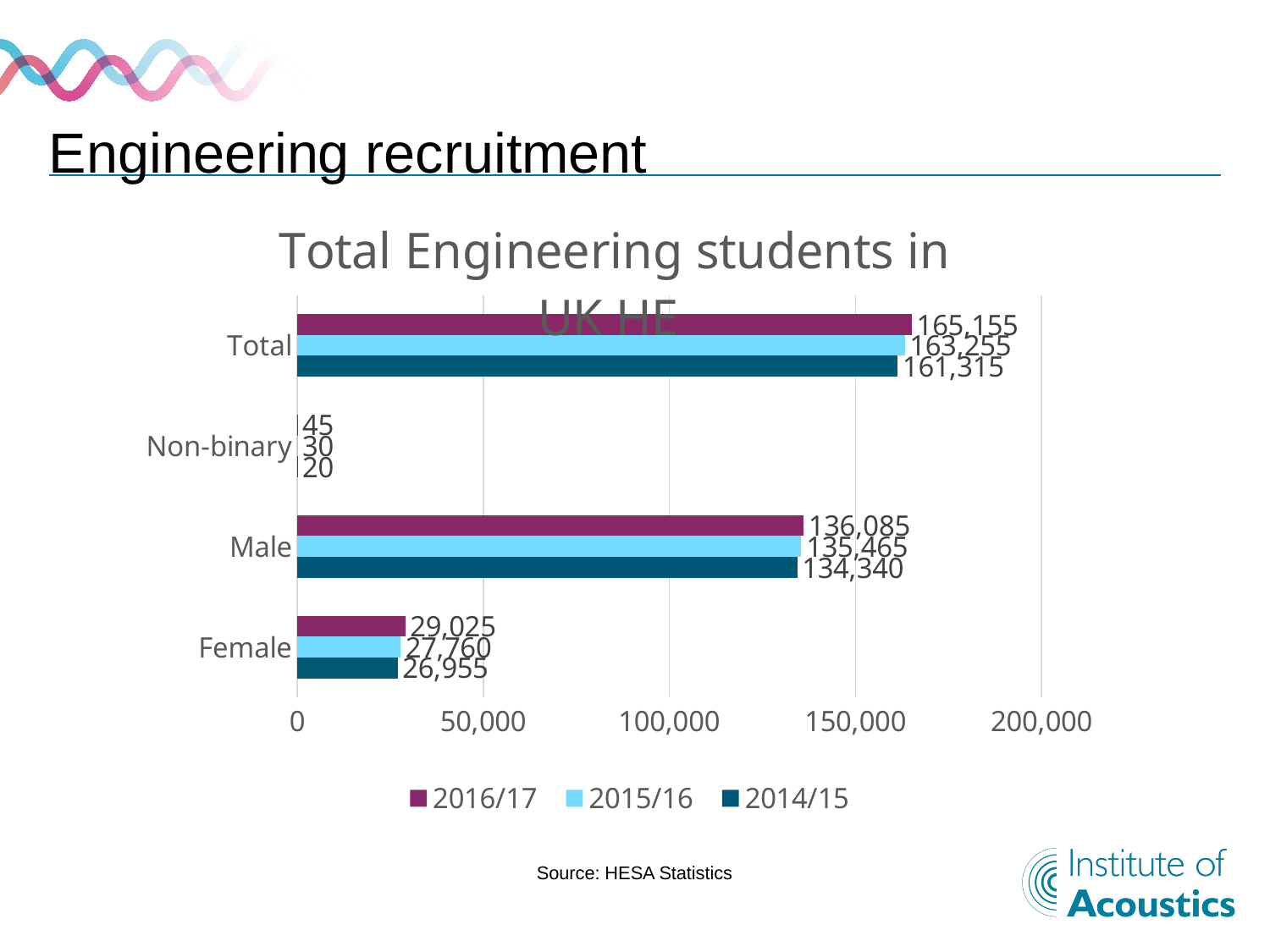
What is the Total value for 2015/16? 163,255 What is the value for Male in 2014/15? 134,340 What is the value for Non-binary in 2015/16? 30 What kind of chart is shown on the slide? Bar chart What is the difference between the Total values for 2016/17 and 2014/15? 3,840 What is the value for Female in 2016/17? 29,025 How many series does the legend list? 3 Which series is shown in the darkest blue colour in the legend? 2014/15 Which category has the lowest values across all three years? Non-binary How many categories are shown on the vertical axis? 4 What is the difference between the Female values for 2016/17 and 2015/16? 1,265 Which is larger, the Male value for 2016/17 or the Female value for 2016/17? Male value for 2016/17